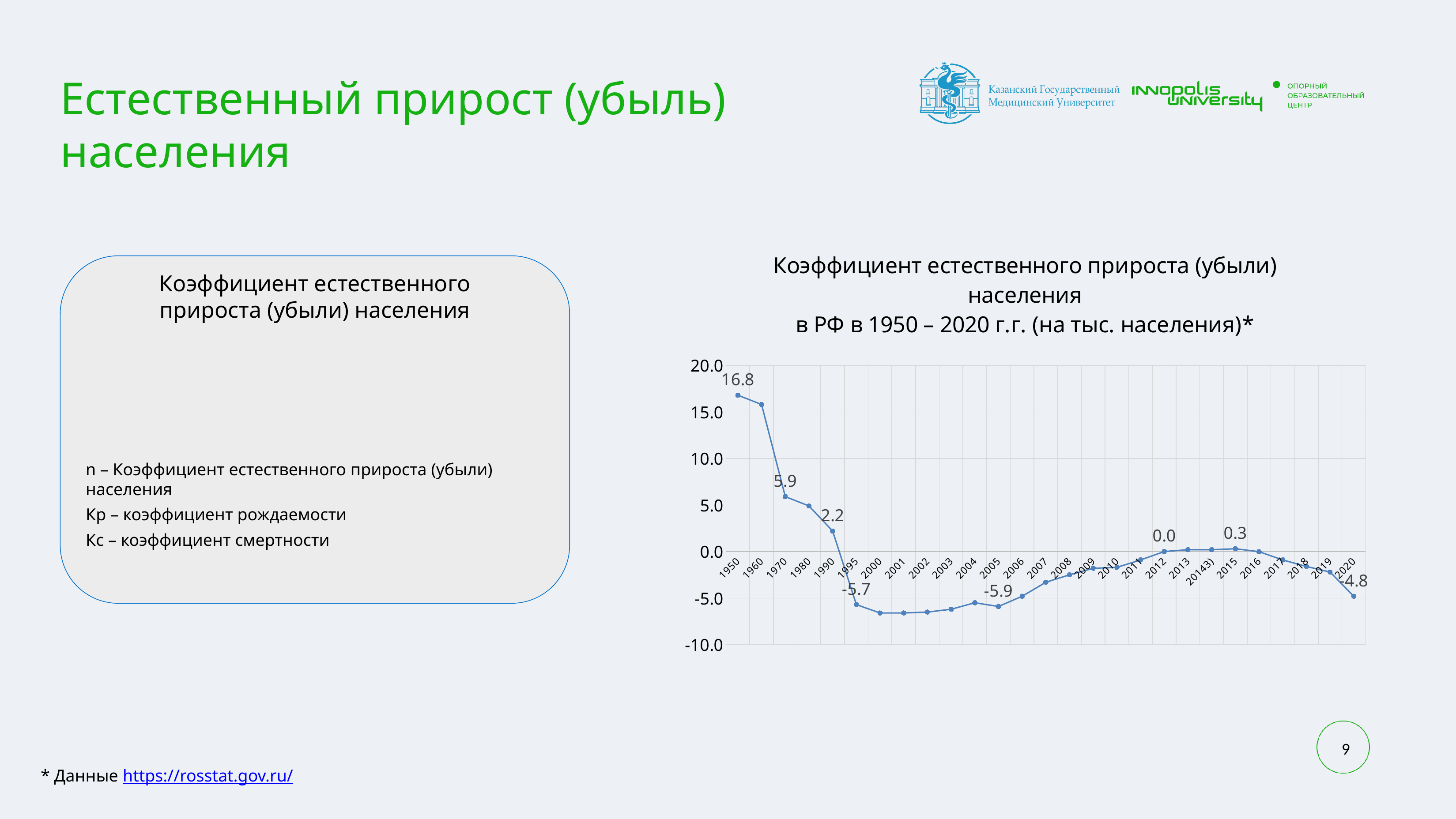
What is the value for 1990 on the chart? 2.2 Do the values rise or fall from 1950 to 1990? fall Is the value for 1960 greater or less than 15.0? greater What is the value for 1995 on the chart? -5.7 What kind of chart is shown on the slide? line chart What is the value for 2005 on the chart? -5.9 Which is larger, the value for 2015 or the value for 2012? 2015 What is the difference between the values for 1950 and 1970? 10.9 What is the value for 1950 on the chart? 16.8 What is the value for 2020 on the chart? -4.8 What is the value for 1970 on the chart? 5.9 Which year has the highest value on the chart? 1950